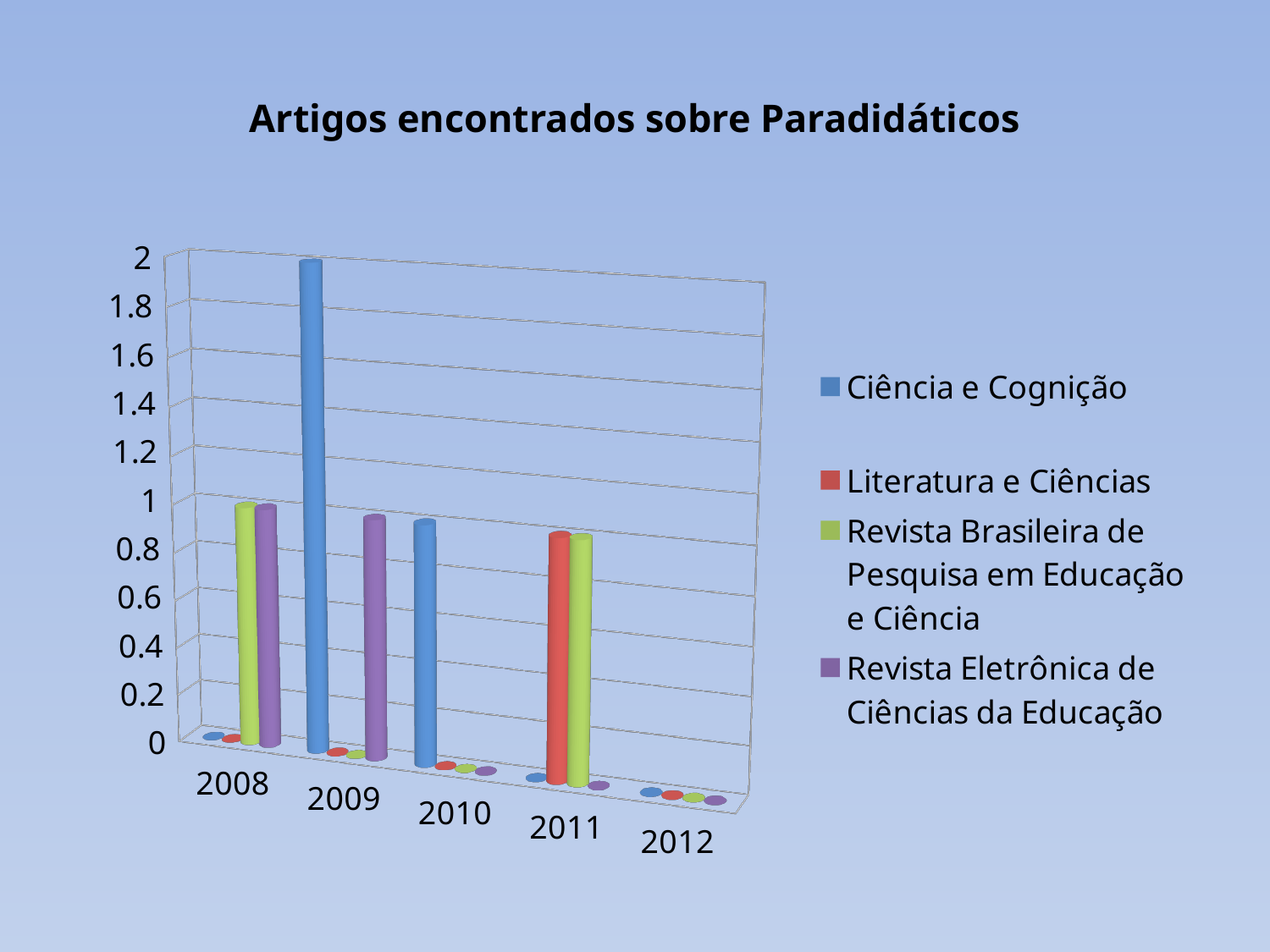
How many years are shown on the x axis? 5 Which colour represents Literatura e Ciências in the legend? red Which is larger: the value for Ciência e Cognição in 2009 or in 2010? 2009 Is the value for Ciência e Cognição in 2009 greater or less than 1? greater Is the value for Ciência e Cognição in 2010 greater or less than 1.5? less Which series has the tallest bar in the chart? Ciência e Cognição How many series does the legend list? 4 What kind of chart is shown on the slide? bar chart In which year does the tallest bar appear? 2009 What is the title of the chart? Artigos encontrados sobre Paradidáticos Is the value for Literatura e Ciências in 2011 greater or less than 0.4? greater